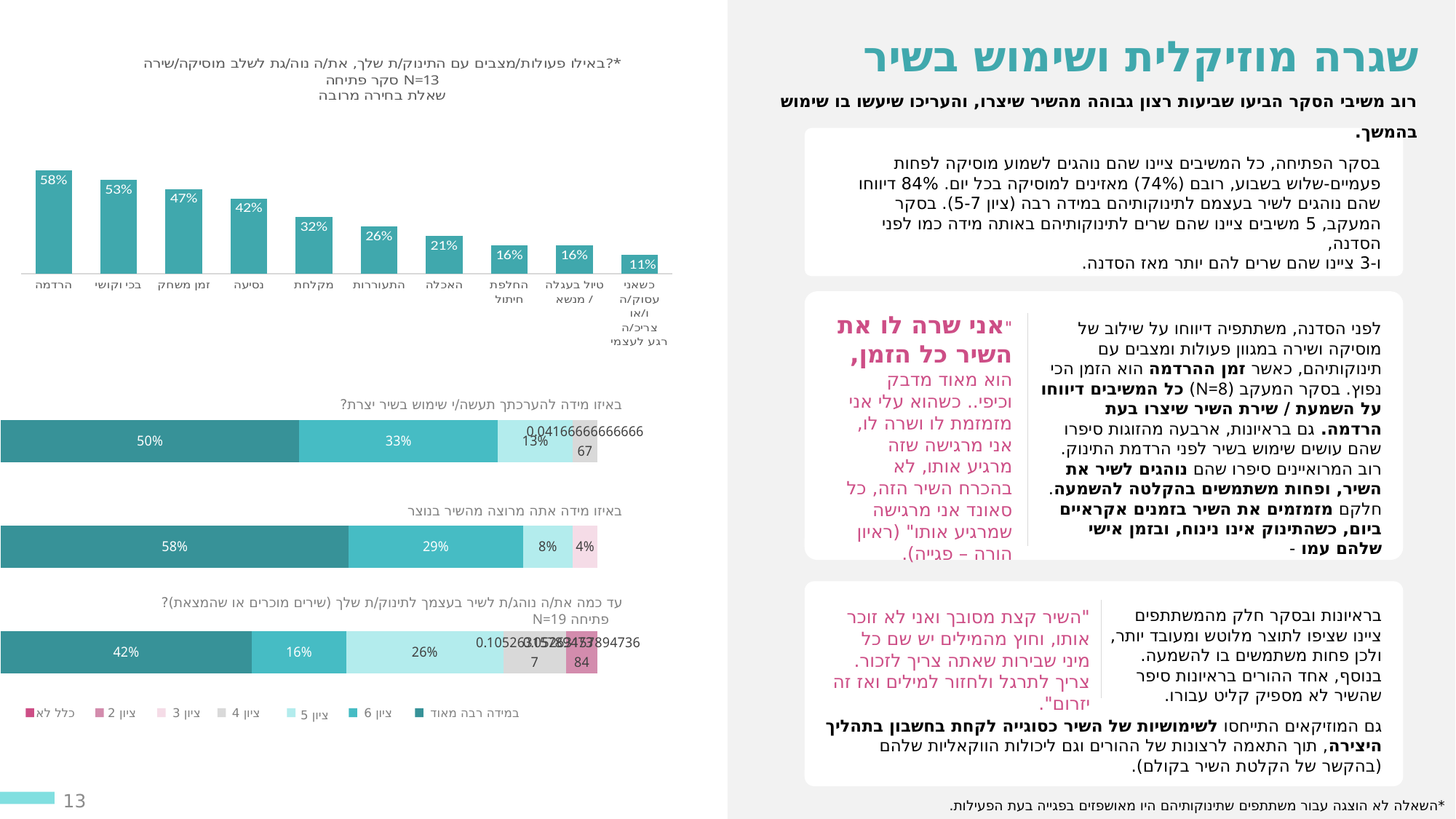
In the top bar chart about activities/situations where music or singing is used with the baby, which category has the highest value? הרדמה How many entries does the legend below the stacked bar charts list? 7 In the top bar chart about activities/situations where music or singing is used with the baby, which category has the lowest value? כשאני עסוק/ה ו/או צריכ/ה רגע לעצמי In the stacked bar chart 'באיזו מידה אתה מרוצה מהשיר בנוצר', what is the value of the ציון 6 segment? 29% What kind of chart is the top chart about activities/situations where music or singing is used with the baby? Bar chart In the stacked bar chart 'באיזו מידה אתה מרוצה מהשיר בנוצר', what is the value of the במידה רבה מאוד segment? 58% How many categories are shown in the top bar chart about activities/situations where music or singing is used with the baby? 10 In the top bar chart about activities/situations where music or singing is used with the baby, what is the difference between הרדמה and נסיעה? 16 percentage points In the top bar chart about activities/situations where music or singing is used with the baby, which is larger: זמן משחק or מקלחת? זמן משחק In the top bar chart about activities/situations where music or singing is used with the baby, what is the value for הרדמה? 58% In the stacked bar chart 'עד כמה את/ה נוהג/ת לשיר בעצמך לתינוק/ת שלך', what is the value of the במידה רבה מאוד segment? 42% In the top bar chart about activities/situations where music or singing is used with the baby, what is the value for מקלחת? 32%